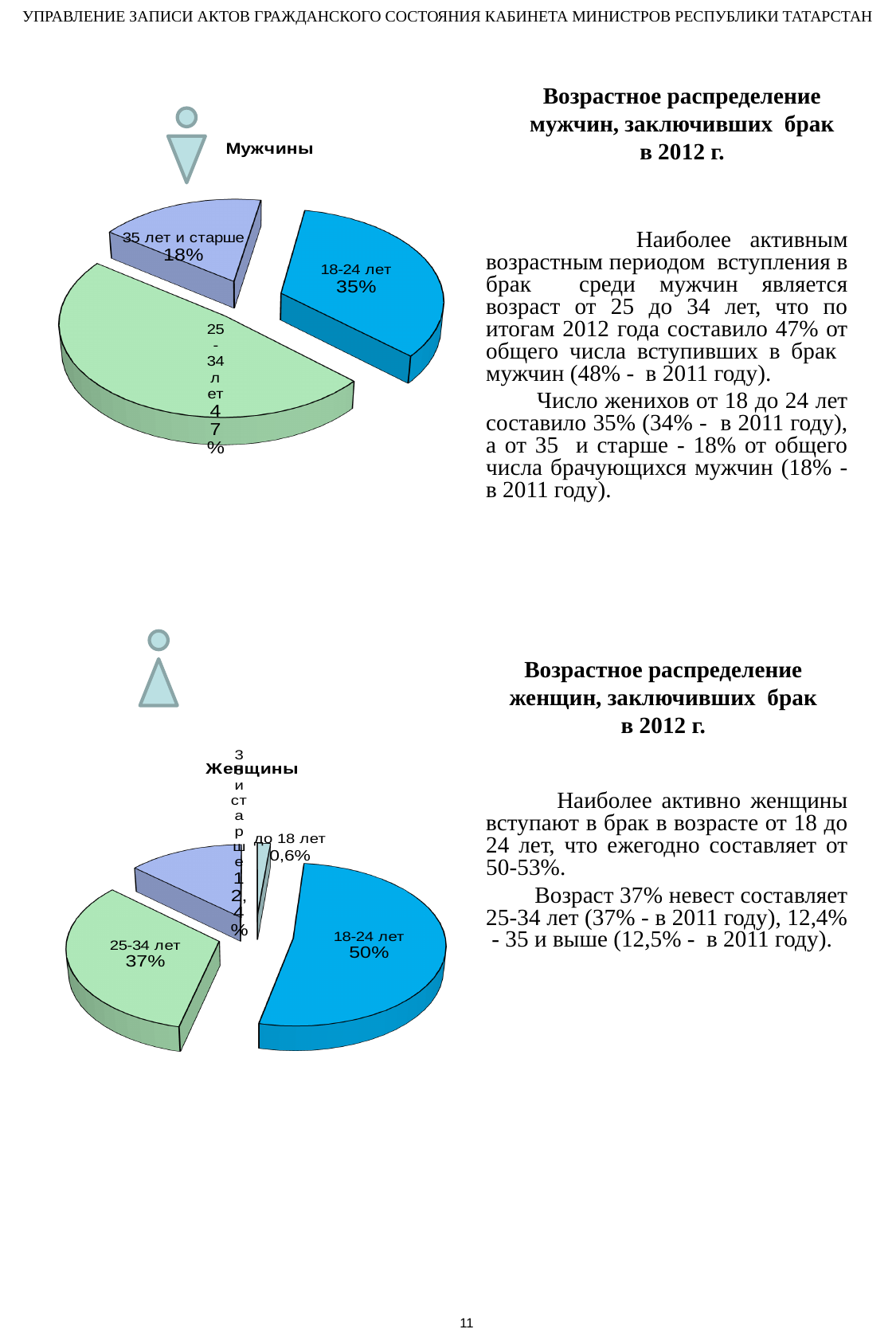
How many slices does the "Женщины" pie chart have? 4 In the "Женщины" pie chart, what share of women who married in 2012 were aged 18-24 лет? 50% In the "Мужчины" pie chart, how many percentage points larger is the 25-34 лет slice than the 18-24 лет slice? 12 In the "Женщины" pie chart, what share is shown for 25-34 лет? 37% In the "Мужчины" pie chart, which age group has the smallest share? 35 лет и старше What type of chart is used for the "Мужчины" data? Pie chart In the "Мужчины" pie chart, what share is shown for 35 лет и старше? 18% In the "Мужчины" pie chart, what share of men who married in 2012 were aged 18-24 лет? 35% In the "Мужчины" pie chart, what share is shown for the 25-34 лет slice? 47% In the "Женщины" pie chart, which age group has the smallest share? до 18 лет In the "Женщины" pie chart, what share is shown for the до 18 лет slice? 0,6% In the "Мужчины" pie chart, which age group has the largest share? 25-34 лет